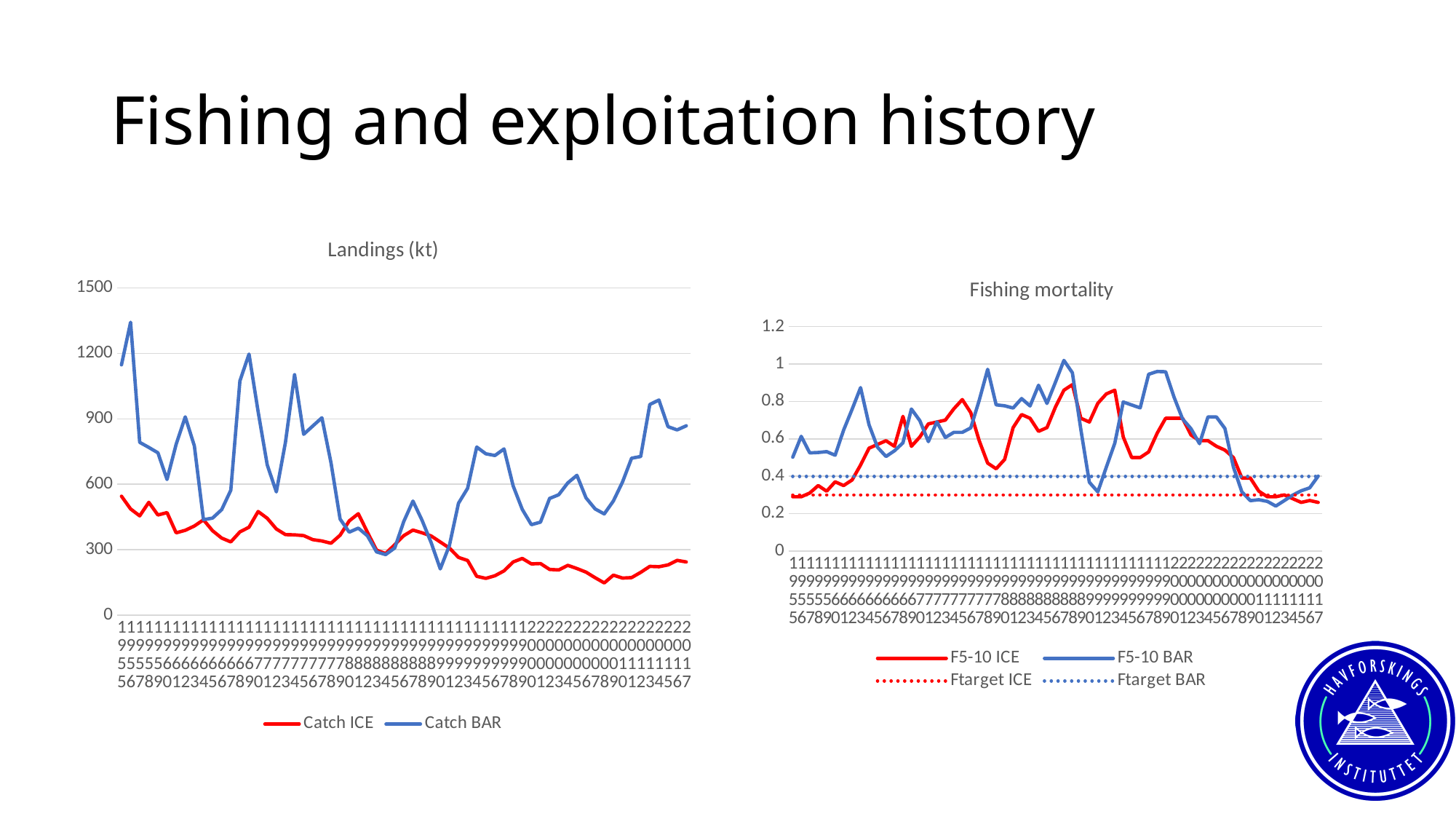
What is the title of the chart on the left of the slide? Landings (kt) How many series does the legend of the 'Landings (kt)' chart list? 2 In the 'Landings (kt)' chart, does Catch ICE overall rise or fall from 1955 to 2017? fall How many series does the legend of the 'Fishing mortality' chart list? 4 In the 'Landings (kt)' chart, is the value of Catch ICE in 1955 greater or less than 300? greater What kind of chart is the 'Fishing mortality' chart? line chart In the 'Fishing mortality' chart, which target line is higher, Ftarget ICE or Ftarget BAR? Ftarget BAR In the 'Fishing mortality' chart, what is the value of the flat dotted Ftarget BAR line? 0.4 In the 'Landings (kt)' chart, is the highest value of Catch BAR greater or less than 1200? greater What kind of chart is the 'Landings (kt)' chart? line chart In the 'Landings (kt)' chart, which series reaches the higher peak, Catch ICE or Catch BAR? Catch BAR